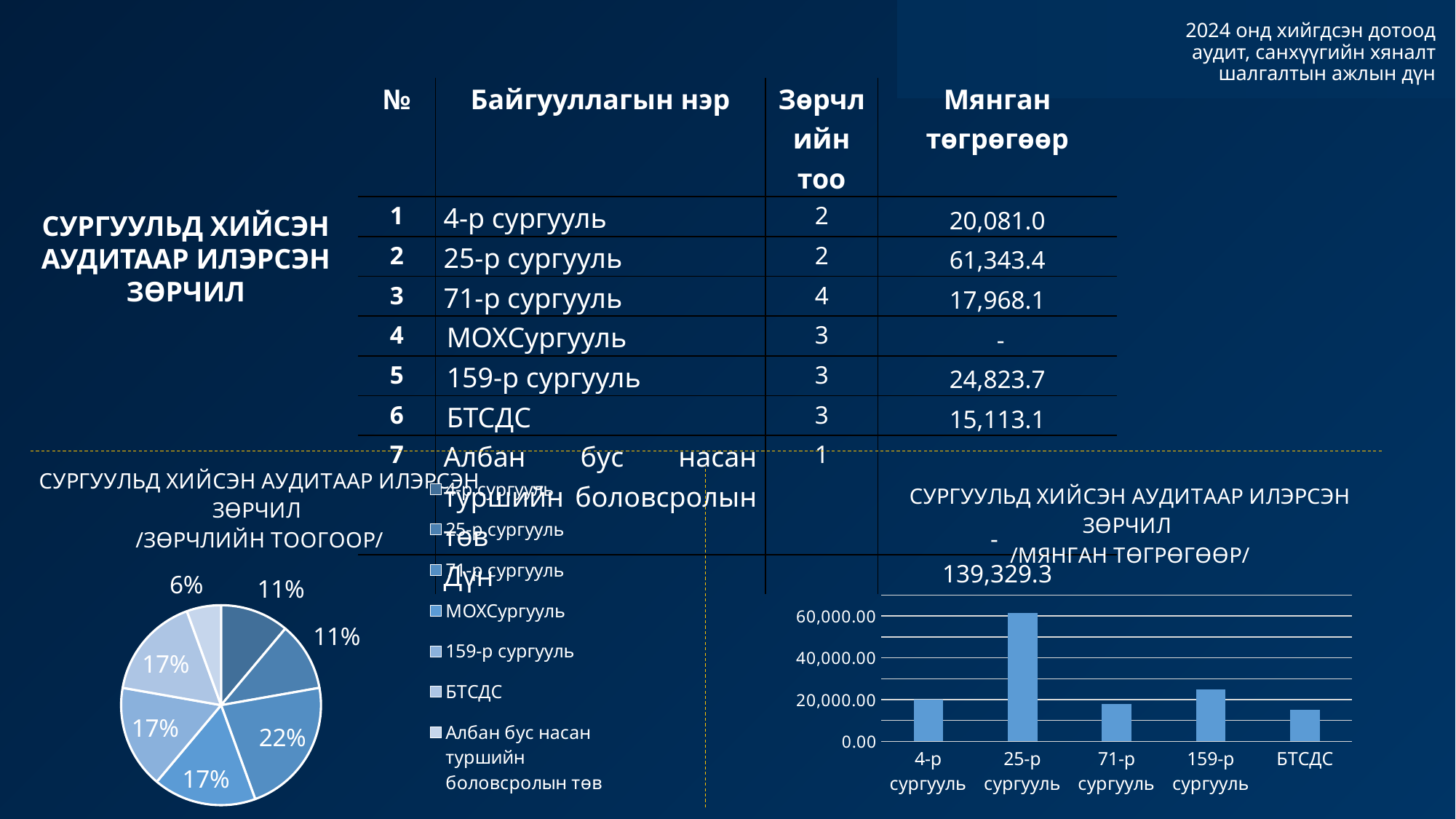
What kind of chart is the chart on the left of the slide (/ЗӨРЧЛИЙН ТООГООР/)? pie chart In the bar chart on the right, which category has the highest bar? 25-р сургууль In the bar chart on the right, is the value for 159-р сургууль greater or less than 20,000.00? greater In the bar chart on the right, how many categories are shown on the x axis? 5 In the pie chart on the left, what is the largest share shown? 22% What kind of chart is the chart on the right of the slide (/МЯНГАН ТӨГРӨГӨӨР/)? bar chart In the bar chart on the right, which is larger: the value for 159-р сургууль or the value for 71-р сургууль? 159-р сургууль In the bar chart on the right, which category has the lowest bar? БТСДС In the bar chart on the right, is the value for БТСДС greater or less than 20,000.00? less In the pie chart on the left, what is the smallest share shown? 6% In the bar chart on the right, is the value for 25-р сургууль greater or less than 40,000.00? greater In the pie chart on the left, how many slices are there? 7